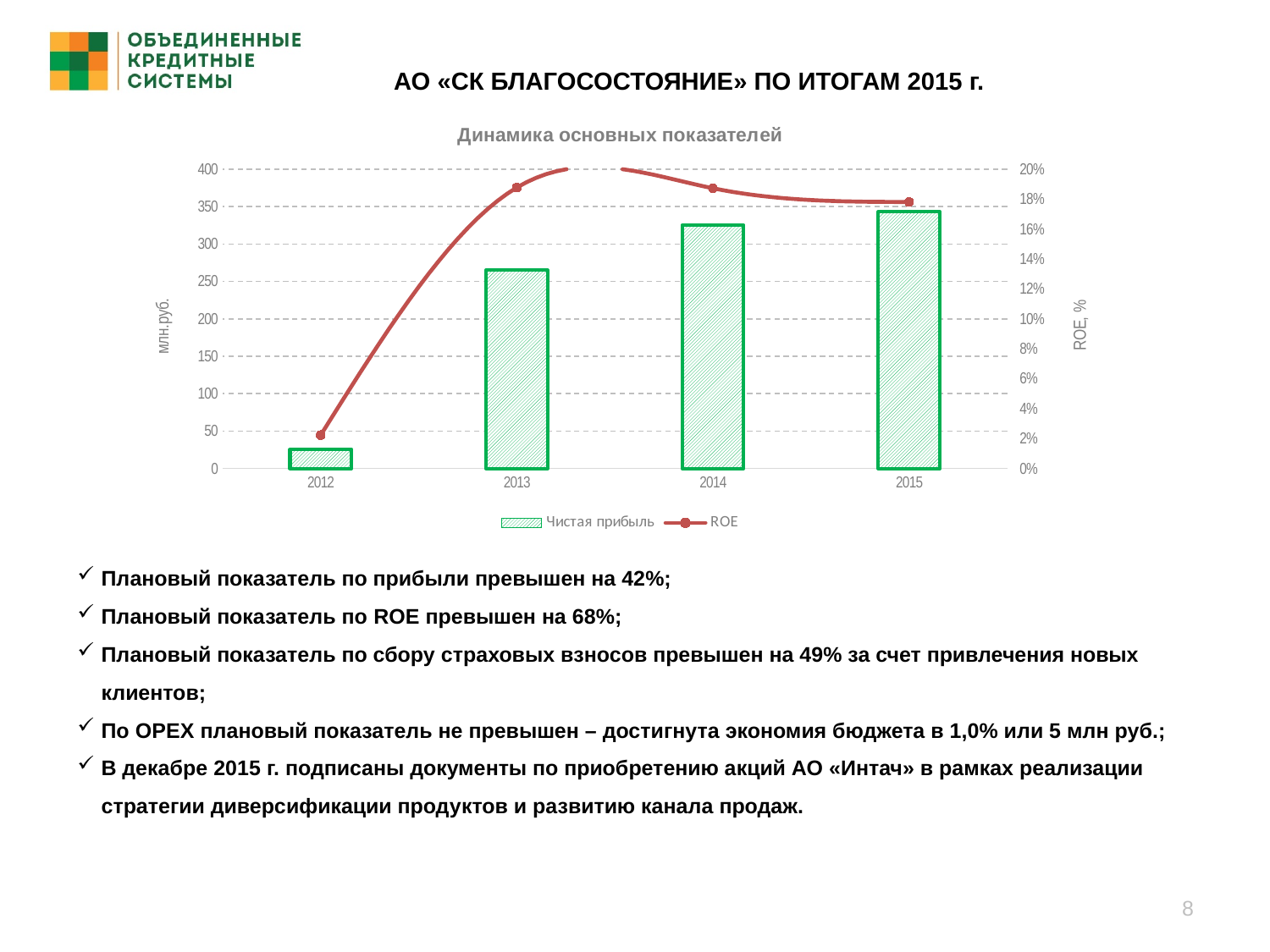
Which year has the lowest net profit (Чистая прибыль) bar? 2012 Does net profit rise or fall from 2012 to 2015? rise Is the net profit for 2014 greater or less than 300 млн.руб.? greater How many years are shown on the x axis of the chart? 4 Is the net profit for 2012 greater or less than 50 млн.руб.? less Which year has the highest net profit (Чистая прибыль) bar? 2015 Which year has the lowest ROE value? 2012 How many series does the chart legend list? 2 What kind of chart is shown under the title «Динамика основных показателей»? Combined bar and line chart Is the net profit for 2014 larger or smaller than the net profit for 2013? larger Is the net profit for 2013 greater or less than 250 млн.руб.? greater